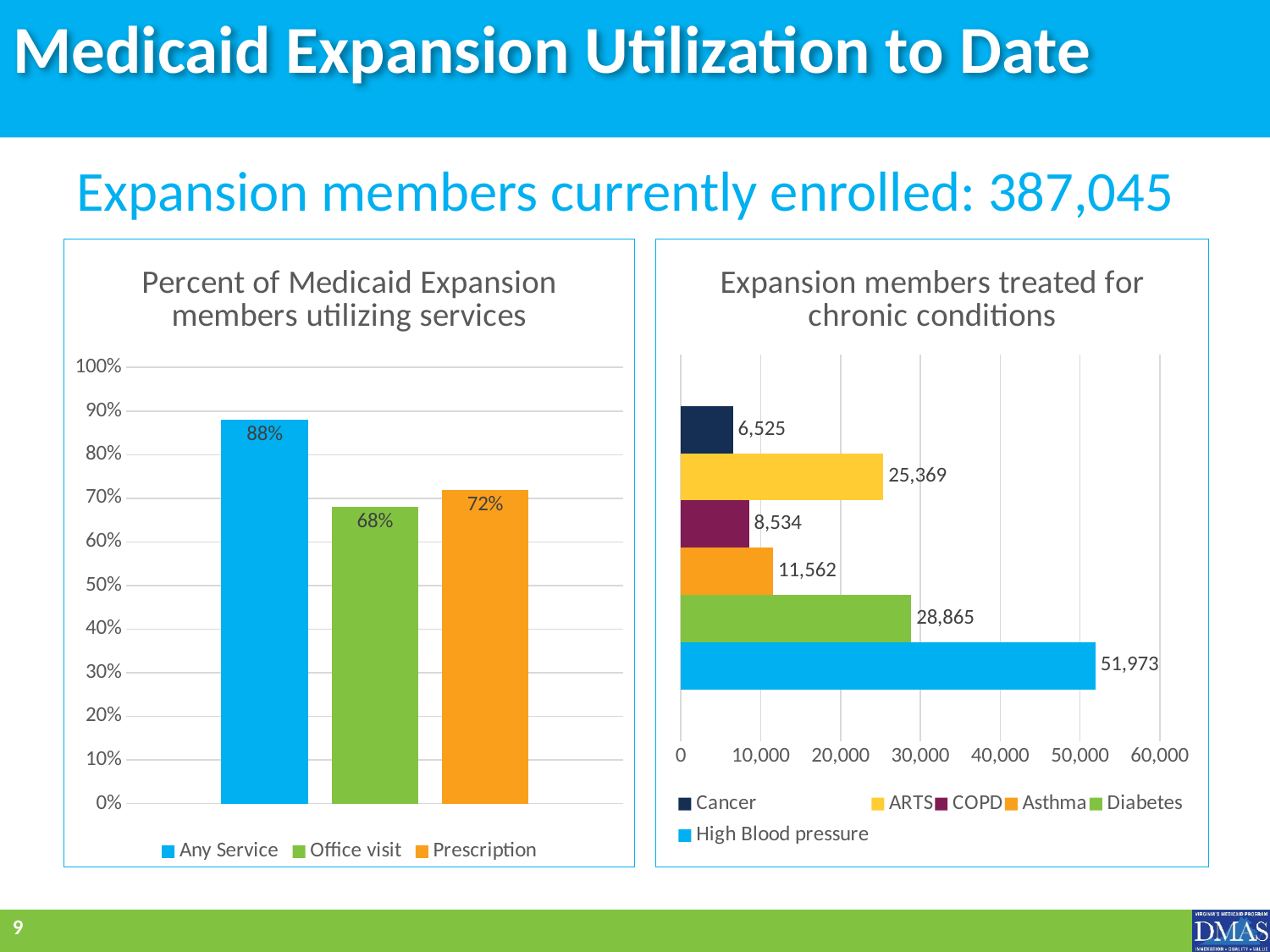
In the 'Percent of Medicaid Expansion members utilizing services' chart, what is the value for Office visit? 68% What kind of chart is the 'Expansion members treated for chronic conditions' chart? Bar chart In the 'Expansion members treated for chronic conditions' chart, what is the difference between High Blood pressure and Diabetes? 23,108 In the 'Expansion members treated for chronic conditions' chart, what is the value for Cancer? 6,525 In the 'Percent of Medicaid Expansion members utilizing services' chart, what is the value for Any Service? 88% In the 'Percent of Medicaid Expansion members utilizing services' chart, how many series does the legend list? 3 In the 'Expansion members treated for chronic conditions' chart, which is larger, ARTS or Asthma? ARTS In the 'Expansion members treated for chronic conditions' chart, how many series does the legend list? 6 In the 'Expansion members treated for chronic conditions' chart, what is the value for Diabetes? 28,865 In the 'Expansion members treated for chronic conditions' chart, which condition has the highest value? High Blood pressure In the 'Percent of Medicaid Expansion members utilizing services' chart, what is the difference between Any Service and Prescription? 16% In the 'Percent of Medicaid Expansion members utilizing services' chart, which series has the lowest value? Office visit